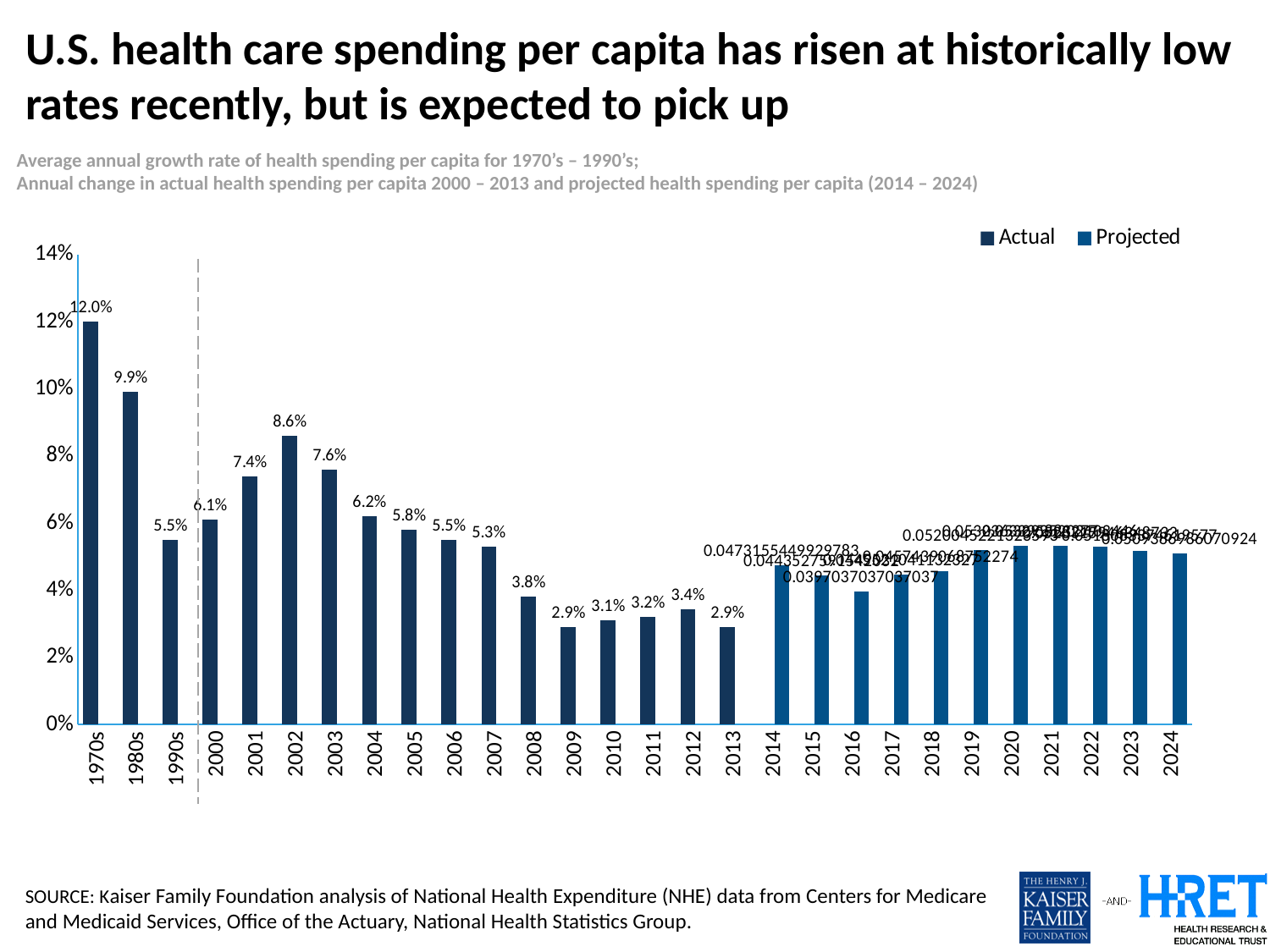
How many series does the legend list? 2 Which is larger, the value for 2001 or the value for 2004? 2001 Is the value for 2014 greater or less than 4%? greater What is the value for the 1970s? 12.0% Among the Actual bars with printed labels, which year has the lowest value? 2009 and 2013 (2.9%) What is the value for 2002? 8.6% What is the difference between the values for 2002 and 2003? 1.0% Do the values rise or fall from 2002 to 2009? Fall Which category has the highest value? 1970s What kind of chart is shown? Bar chart What is the value for 2008? 3.8% What is the value for 2013? 2.9%